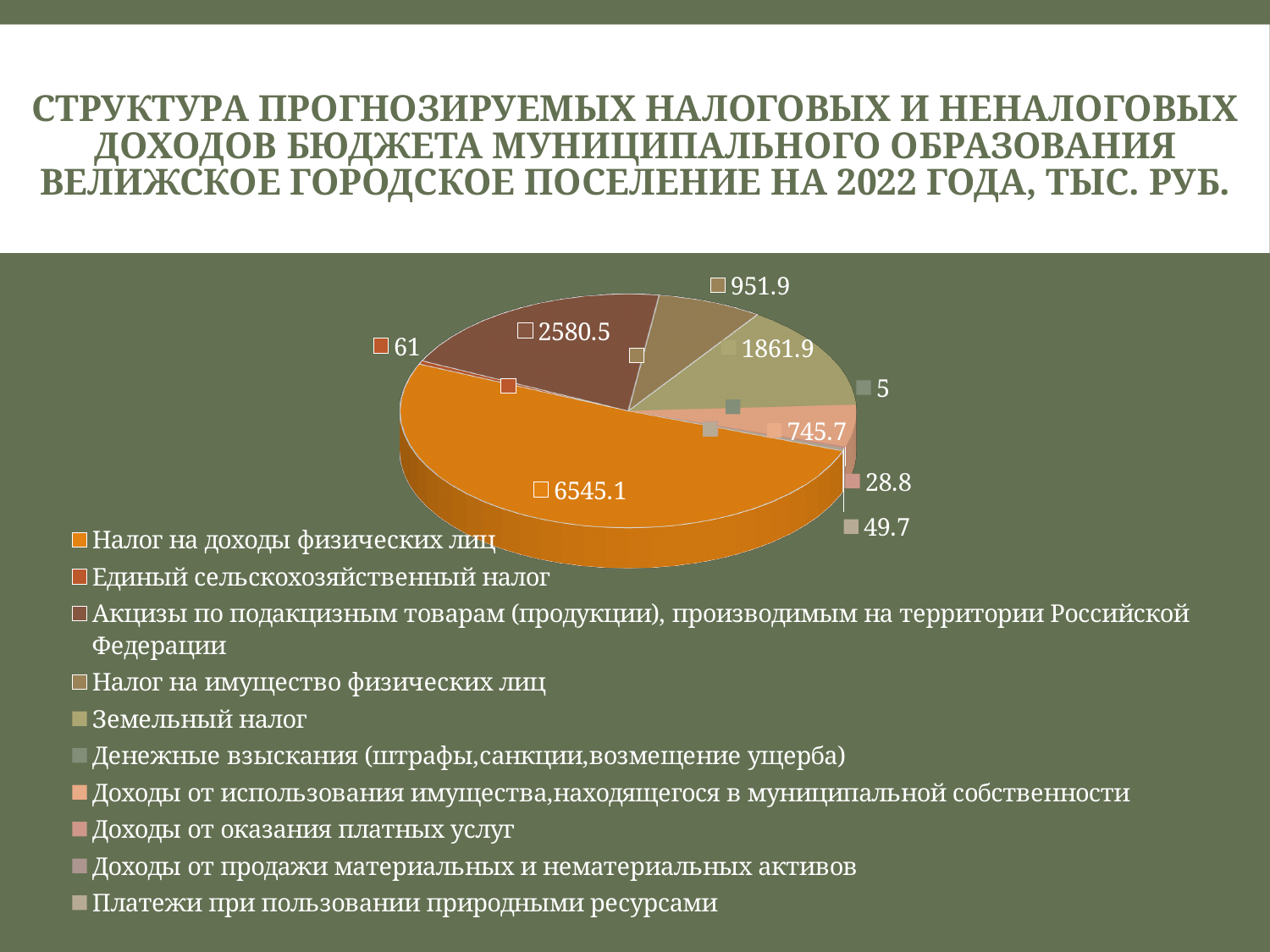
What is the value shown for Акцизы по подакцизным товарам (продукции), производимым на территории Российской Федерации? 2580.5 Which is larger: Земельный налог or Налог на имущество физических лиц? Земельный налог What is the value shown for Земельный налог? 1861.9 What is the value shown for Налог на имущество физических лиц? 951.9 Which category has the largest slice of the pie? Налог на доходы физических лиц What is the difference between the values for Налог на доходы физических лиц and Акцизы по подакцизным товарам? 3964.6 How many categories does the legend list? 10 What is the value shown for Денежные взыскания (штрафы, санкции, возмещение ущерба)? 5 What kind of chart is shown on the slide? pie chart What is the value shown for Налог на доходы физических лиц? 6545.1 What is the value shown for Доходы от использования имущества, находящегося в муниципальной собственности? 745.7 What is the value shown for Единый сельскохозяйственный налог? 61